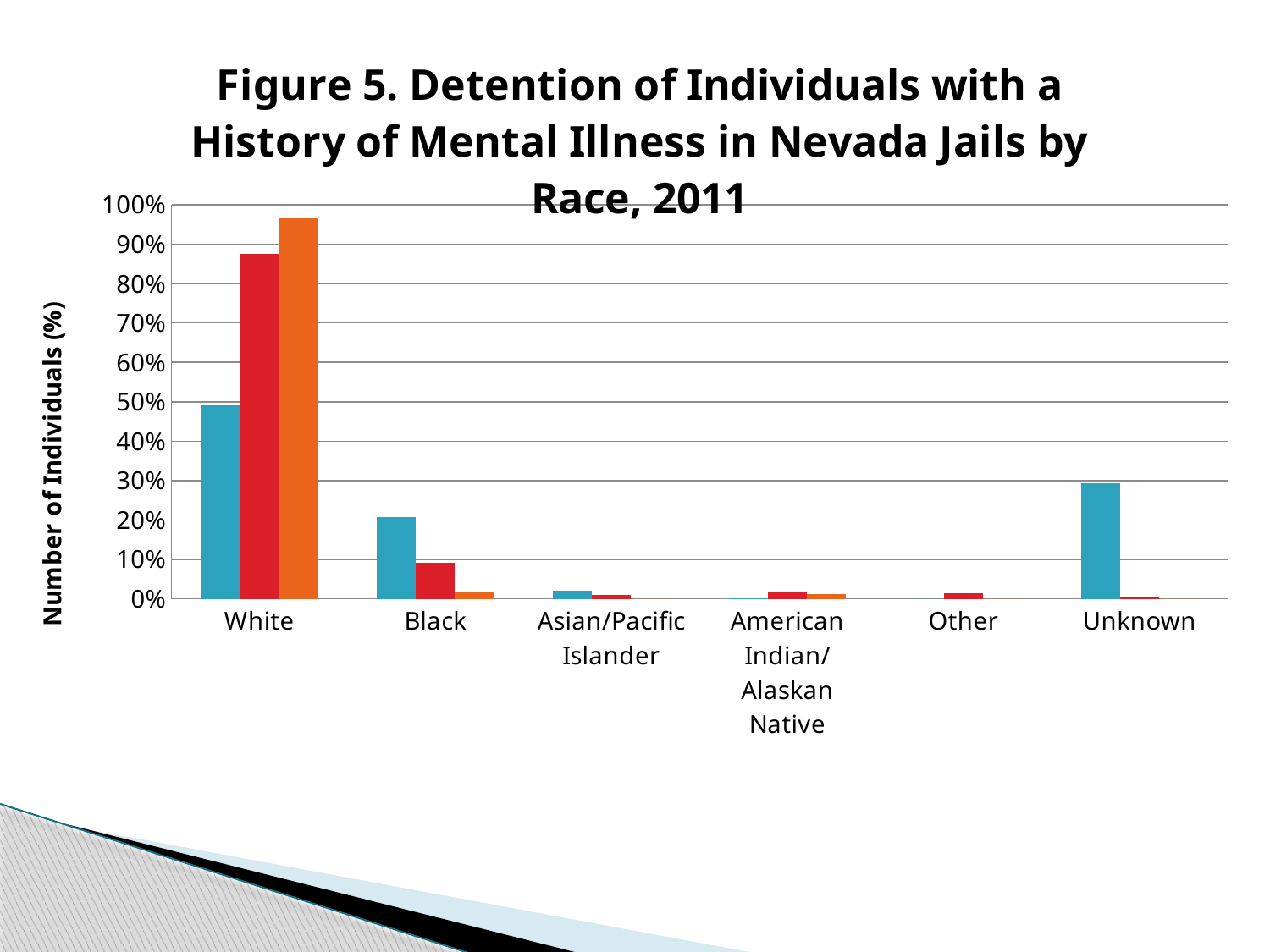
Which is larger for White, the blue bar or the red bar? the red bar Which is larger, the blue bar for Black or the blue bar for Unknown? Unknown Which category has the tallest orange bar? White Is the value of the blue bar for Unknown greater or less than 20%? greater How many race categories are shown on the x axis? 6 Is the value of the red bar for White greater or less than 80%? greater Is the value of the orange bar for White greater or less than 90%? greater What kind of chart is shown on the slide? bar chart What is the title of the chart? Figure 5. Detention of Individuals with a History of Mental Illness in Nevada Jails by Race, 2011 What is the label on the y axis? Number of Individuals (%) Which category has the tallest blue bar? White